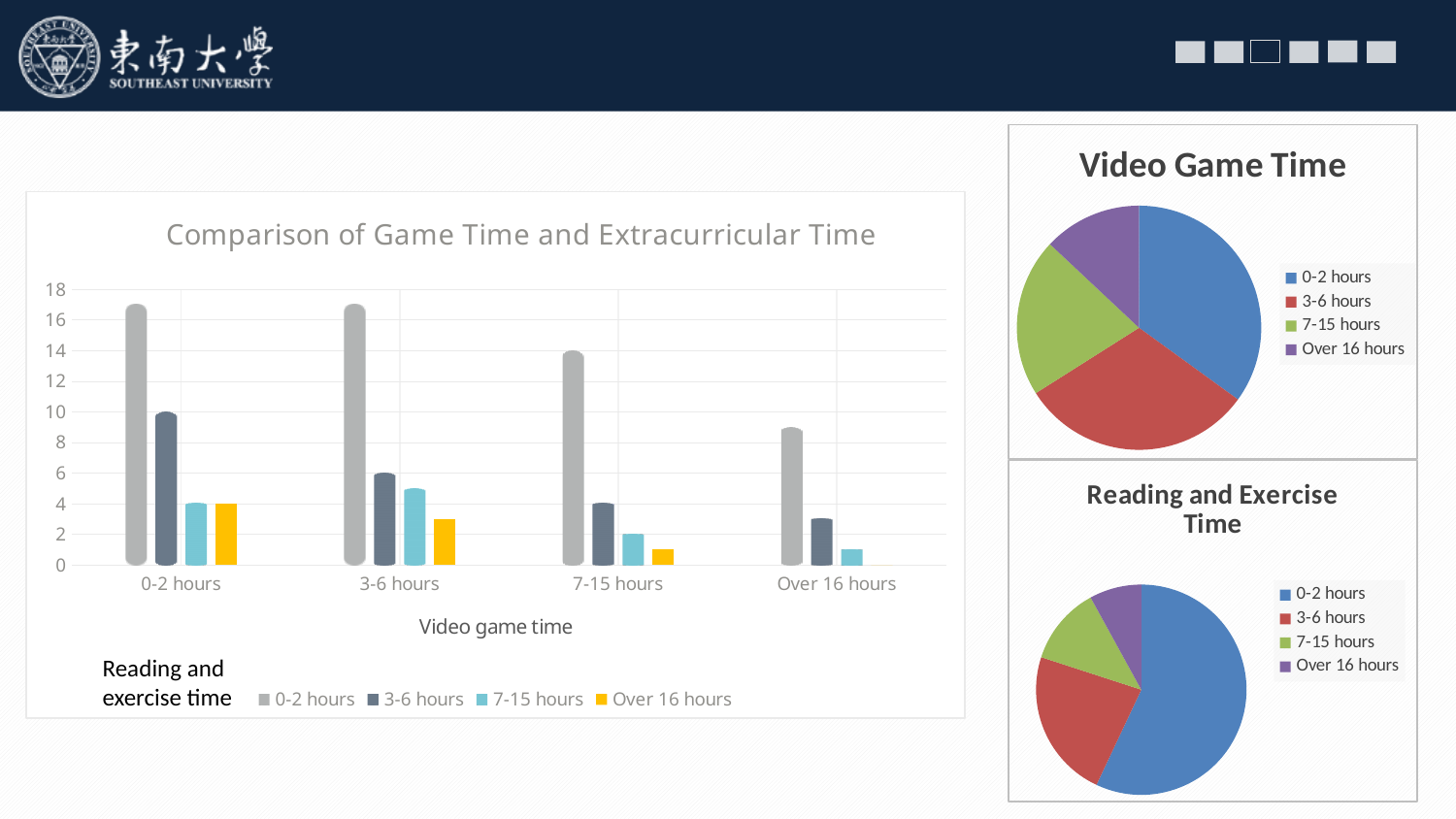
In the 'Video Game Time' pie chart, which category has the largest slice? 0-2 hours In the 'Comparison of Game Time and Extracurricular Time' chart, how many video game time categories are shown on the x axis? 4 In the 'Comparison of Game Time and Extracurricular Time' chart, which is larger: the '3-6 hours' reading and exercise bar in the '0-2 hours' video game time group or in the '3-6 hours' video game time group? 0-2 hours In the 'Comparison of Game Time and Extracurricular Time' chart, which reading and exercise time series has the tallest bar in the '0-2 hours' video game time group? 0-2 hours In the 'Comparison of Game Time and Extracurricular Time' chart, do the '0-2 hours' reading and exercise bars rise or fall as video game time increases along the x axis? fall In the 'Comparison of Game Time and Extracurricular Time' chart, is the 'Over 16 hours' reading and exercise bar in the '7-15 hours' video game time group greater or less than 2? less In the 'Comparison of Game Time and Extracurricular Time' chart, is the '0-2 hours' reading and exercise bar in the 'Over 16 hours' video game time group greater or less than 6? greater What kind of chart is the 'Comparison of Game Time and Extracurricular Time' chart? bar chart In the 'Comparison of Game Time and Extracurricular Time' chart, how many series does the legend list? 4 In the 'Reading and Exercise Time' pie chart, which category has the largest slice? 0-2 hours In the 'Comparison of Game Time and Extracurricular Time' chart, is the '0-2 hours' reading and exercise bar in the '0-2 hours' video game time group greater or less than 14? greater In the 'Video Game Time' pie chart, which category has the smallest slice? Over 16 hours